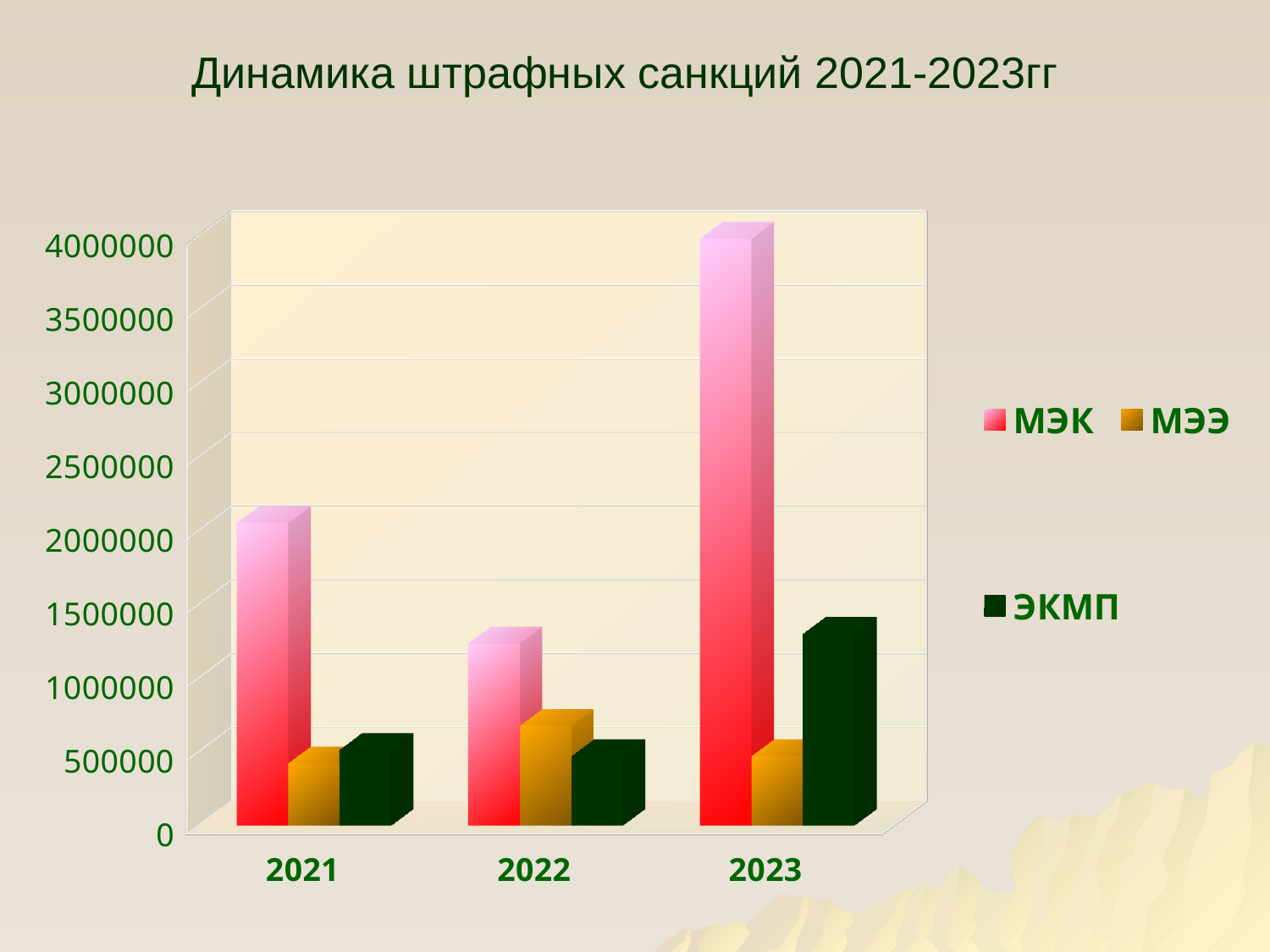
How many years are shown on the x axis? 3 Is the value for МЭК in 2021 greater or less than 1500000? greater How many series does the legend list? 3 Is the value for МЭК in 2023 greater or less than 3500000? greater Is the value for МЭЭ in 2022 greater or less than 1000000? less What kind of chart is shown on the slide? bar chart In which year is the МЭК value highest? 2023 What is the title of the chart? Динамика штрафных санкций 2021-2023гг In which year is the МЭК value lowest? 2022 Which series is shown in dark green in the legend? ЭКМП In 2023, which is larger: the МЭК value or the ЭКМП value? МЭК